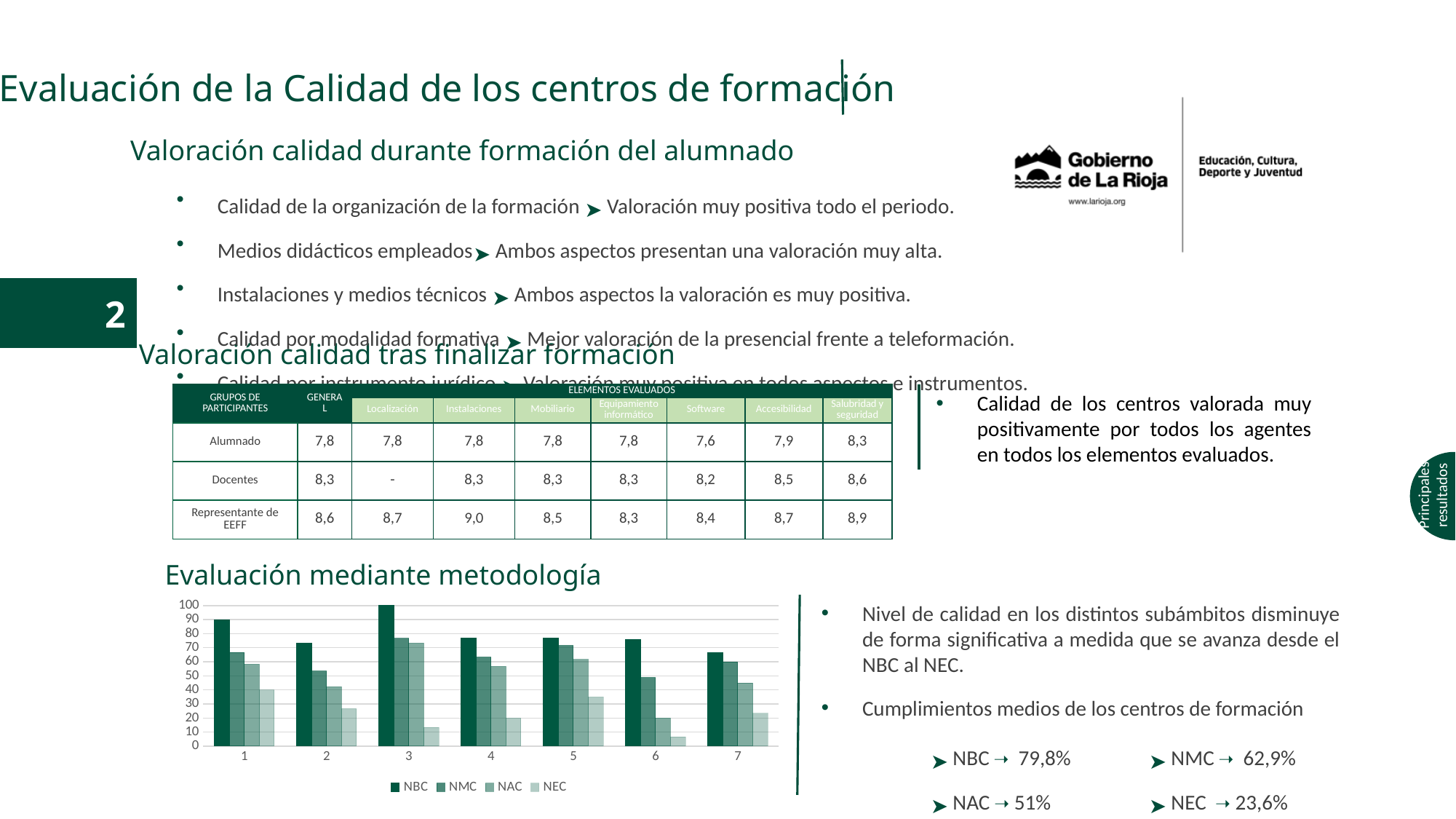
Is the value for NEC in category 6 greater or less than 10? less How many categories are shown on the x axis of the bar chart? 7 In category 7, which is larger, NMC or NEC? NMC Is the value for NBC in category 1 greater or less than 80? greater Which series are listed in the legend of the bar chart? NBC, NMC, NAC, NEC What kind of chart is shown under "Evaluación mediante metodología"? bar chart In which category does the NEC series have its lowest value in the bar chart? 6 In which category does the NBC series reach its highest value in the bar chart? 3 Is the value for NMC in category 1 greater or less than 60? greater How many series does the legend of the bar chart list? 4 In category 3, which is larger, NBC or NEC? NBC